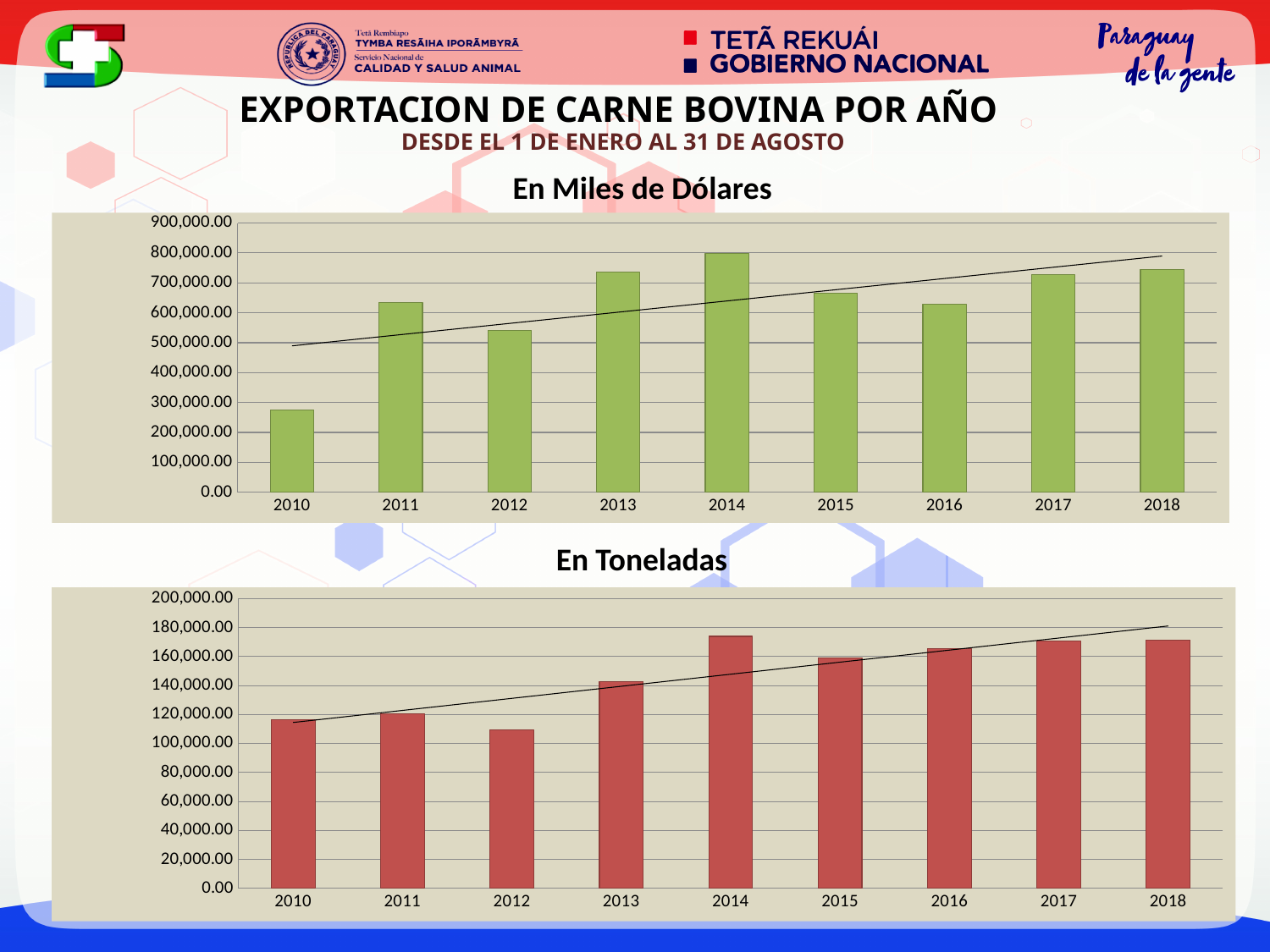
In the 'En Miles de Dólares' chart, which year has the highest value? 2014 In the 'En Toneladas' chart, which is larger, the value for 2013 or the value for 2012? 2013 What kind of chart is the 'En Toneladas' chart? bar chart In the 'En Toneladas' chart, is the value for 2013 greater or less than 160,000.00? less In the 'En Miles de Dólares' chart, is the value for 2010 greater or less than 300,000.00? less In the 'En Toneladas' chart, which year has the lowest value? 2012 How many years are shown on the x axis of the 'En Miles de Dólares' chart? 9 What colour are the bars in the 'En Toneladas' chart? red In the 'En Miles de Dólares' chart, which is larger, the value for 2011 or the value for 2012? 2011 In the 'En Toneladas' chart, is the value for 2014 greater or less than 160,000.00? greater In the 'En Miles de Dólares' chart, which year has the lowest value? 2010